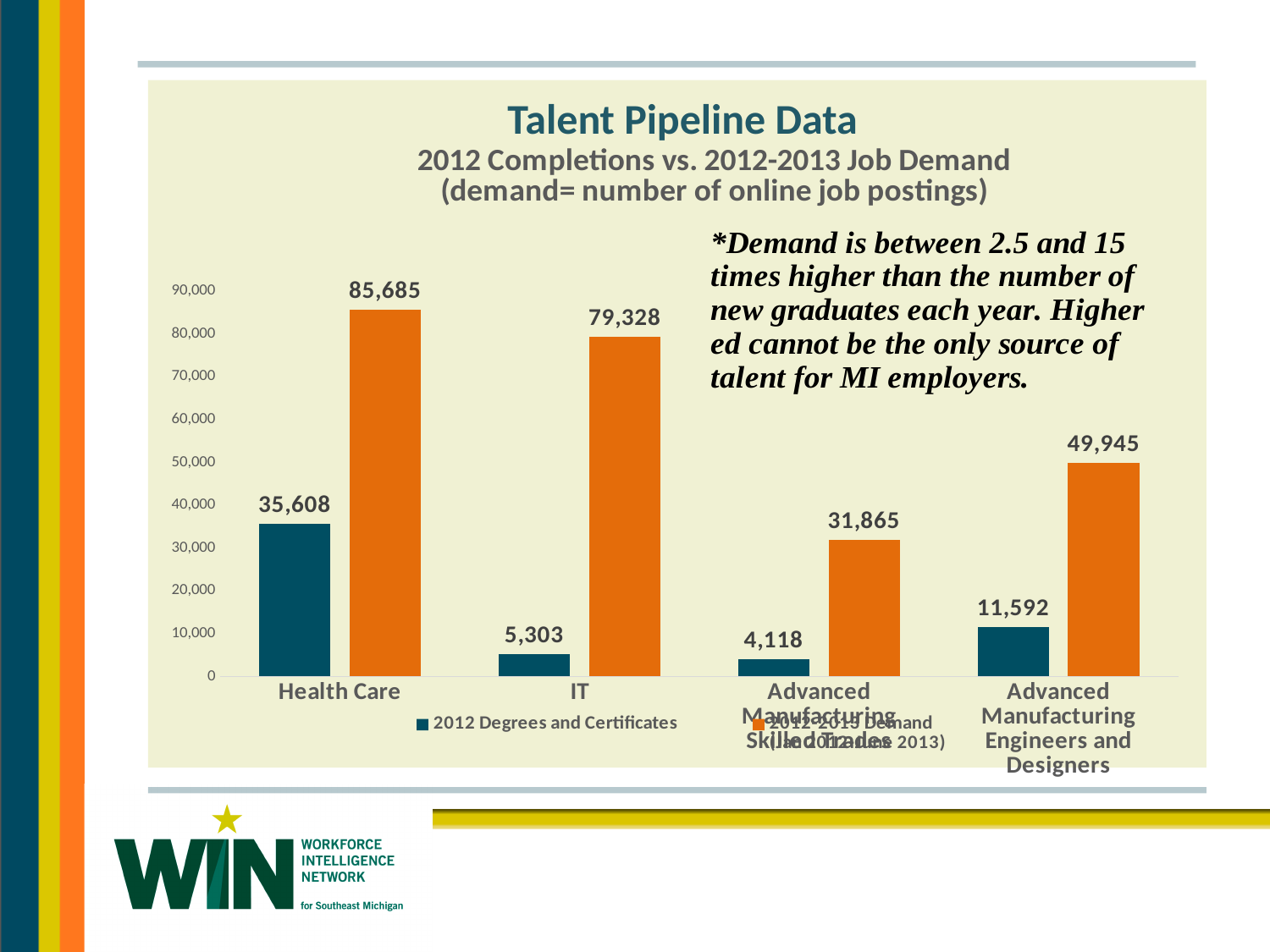
Is the 2012-2013 Demand value for Advanced Manufacturing Engineers and Designers greater or less than 40,000? greater How many categories are shown on the x axis? 4 Which category has the highest 2012-2013 Demand value? Health Care What is the 2012-2013 Demand value for IT? 79,328 Which category has the lowest 2012 Degrees and Certificates value? Advanced Manufacturing Skilled Trades What is the 2012 Degrees and Certificates value for Advanced Manufacturing Engineers and Designers? 11,592 How many series does the legend list? 2 What is the 2012-2013 Demand value for Advanced Manufacturing Skilled Trades? 31,865 What is the difference between the 2012-2013 Demand and the 2012 Degrees and Certificates values for Health Care? 50,077 Which is larger: the 2012 Degrees and Certificates value for IT or for Advanced Manufacturing Engineers and Designers? Advanced Manufacturing Engineers and Designers What is the 2012 Degrees and Certificates value for Health Care? 35,608 What kind of chart is shown on the slide? bar chart